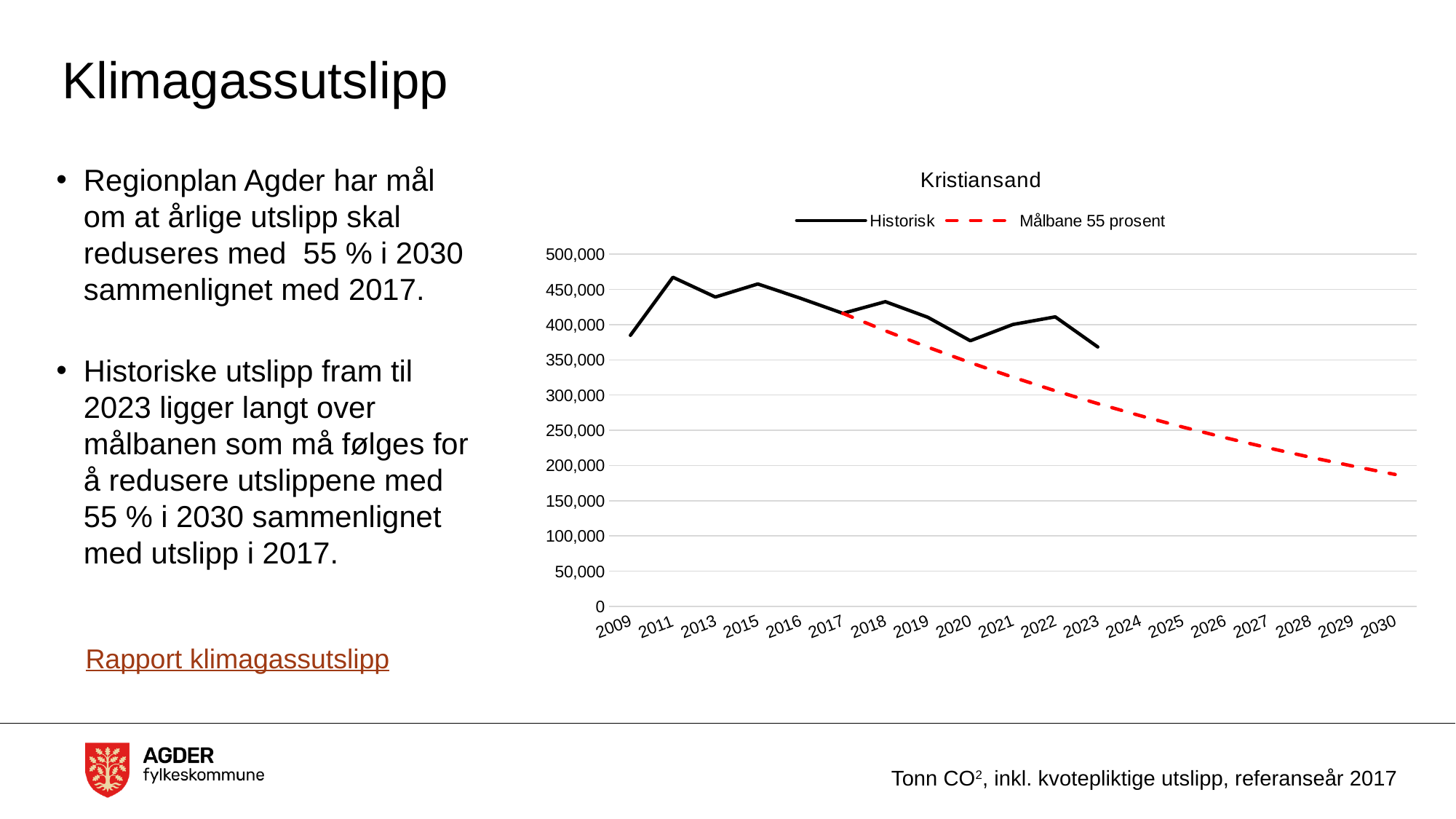
Is the Målbane 55 prosent value for 2024 greater or less than 350,000? less In which year does the Historisk series reach its highest value? 2011 What is the title of the chart? Kristiansand Is the Historisk value for 2009 greater or less than 400,000? less In 2023, which is larger: the Historisk value or the Målbane 55 prosent value? Historisk In which year does the Målbane 55 prosent series reach its lowest value? 2030 Is the Historisk value for 2011 greater or less than 450,000? greater What kind of chart is shown on the slide? line chart How many series does the chart legend list? 2 Which series is drawn as a red dashed line? Målbane 55 prosent How many year labels are shown on the x axis? 19